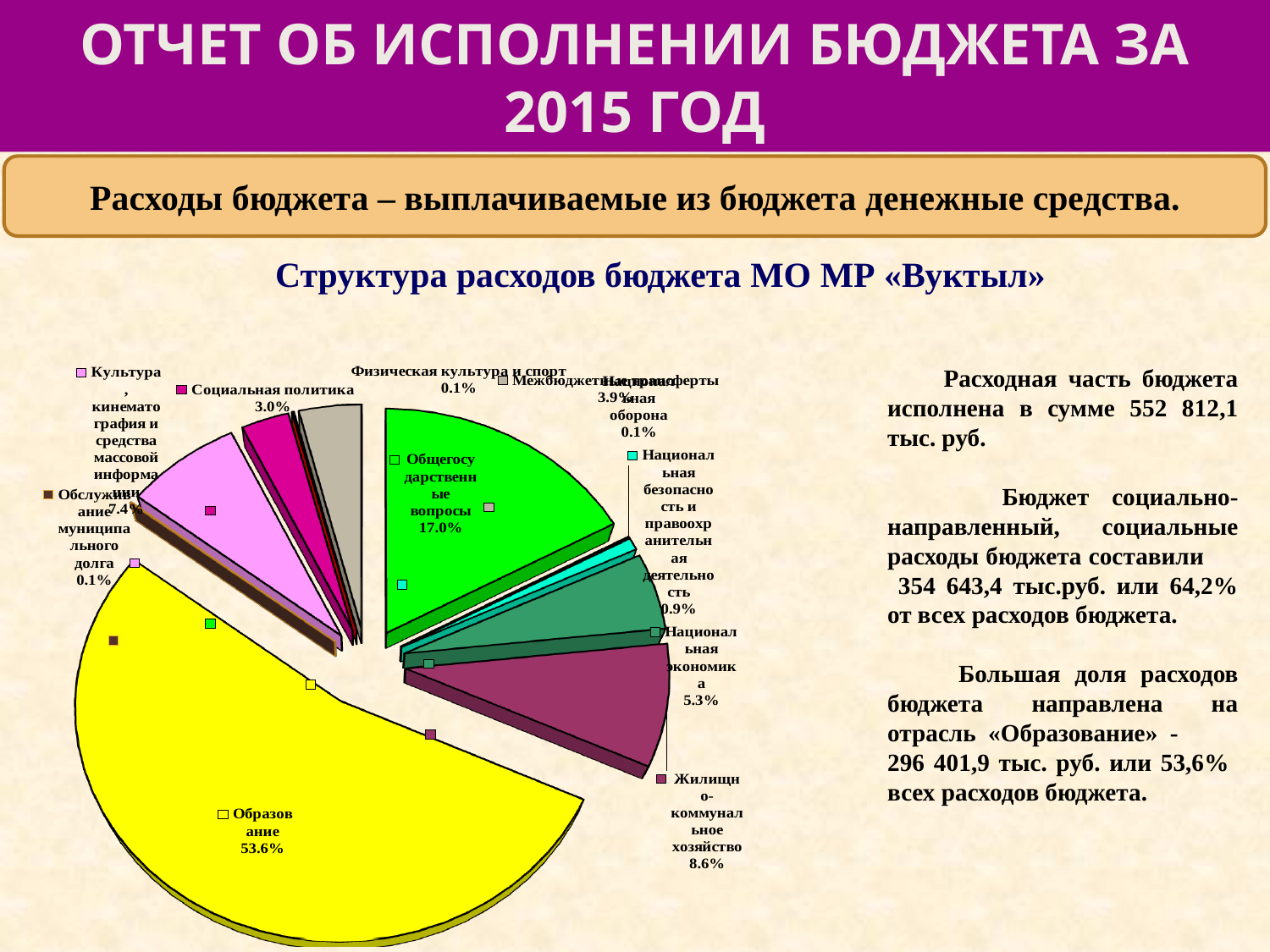
What is the value shown for Культура, кинематография и средства массовой информации? 7.4% What is the value shown for Национальная экономика? 5.3% What is the value shown for Социальная политика? 3.0% What is the value shown for Национальная безопасность и правоохранительная деятельность? 0.9% What is the value shown for Жилищно-коммунальное хозяйство? 8.6% What is the difference in percentage points between the share for Образование and the share for Общегосударственные вопросы? 36.6 Which is larger, the share for Жилищно-коммунальное хозяйство or the share for Национальная экономика? Жилищно-коммунальное хозяйство What kind of chart is shown on the slide? pie chart What is the value shown for Общегосударственные вопросы? 17.0% Which category has the largest share of the pie? Образование What is the title of the chart? Структура расходов бюджета МО МР «Вуктыл» What share of the pie does Образование have? 53.6%